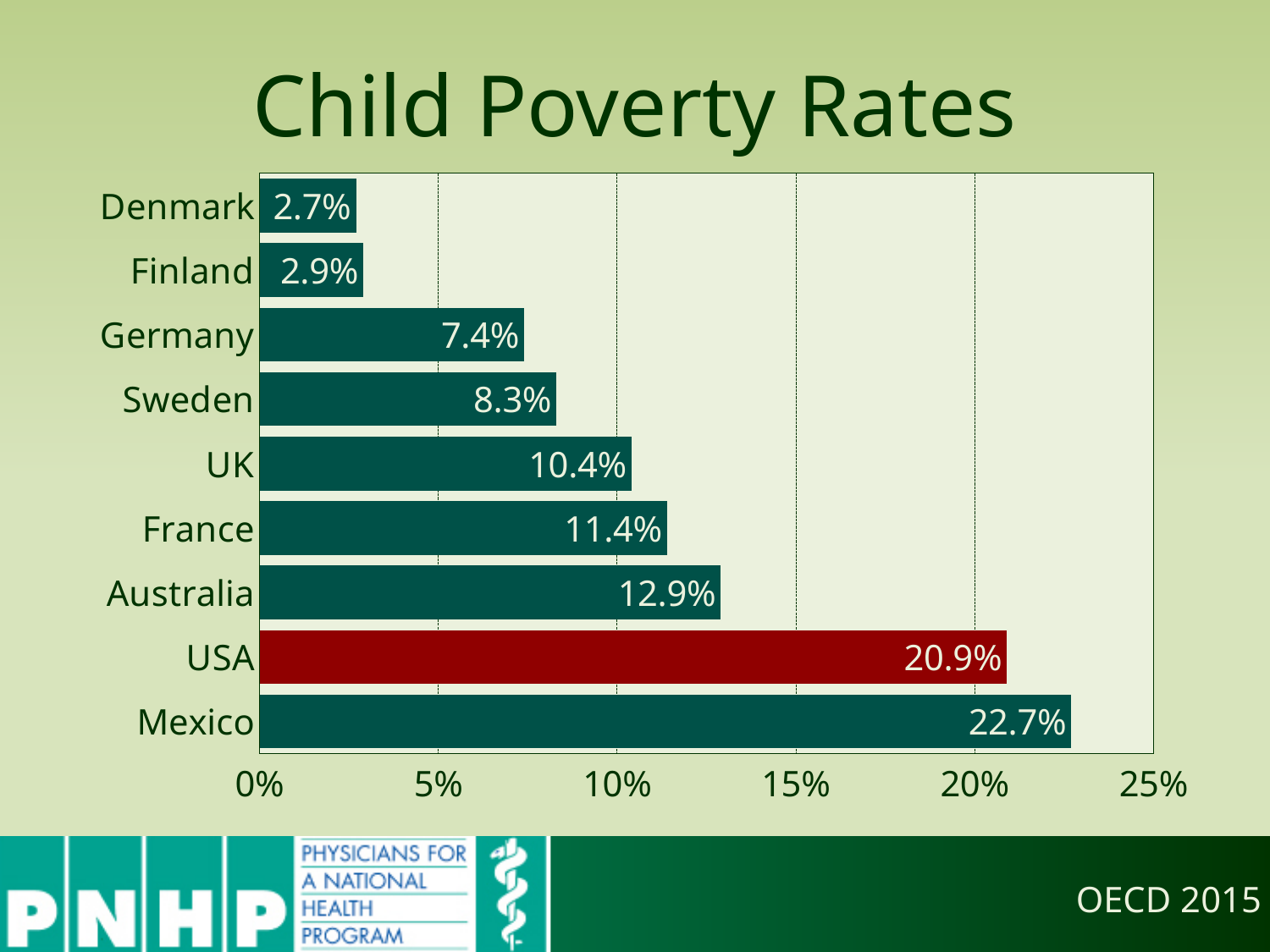
Which has a higher child poverty rate, France or the UK? France What is the child poverty rate for the USA? 20.9% Which country has the highest child poverty rate? Mexico Is the value for Australia greater or less than 10%? greater Which country's bar is coloured red instead of dark green? USA What is the difference between the child poverty rates of Finland and Denmark? 0.2% How many countries are shown in the chart? 9 What is the child poverty rate for Germany? 7.4% What kind of chart is shown on the slide? Bar chart Which country has the lowest child poverty rate? Denmark What is the title of the chart? Child Poverty Rates What is the difference between the child poverty rates of Mexico and the USA? 1.8%